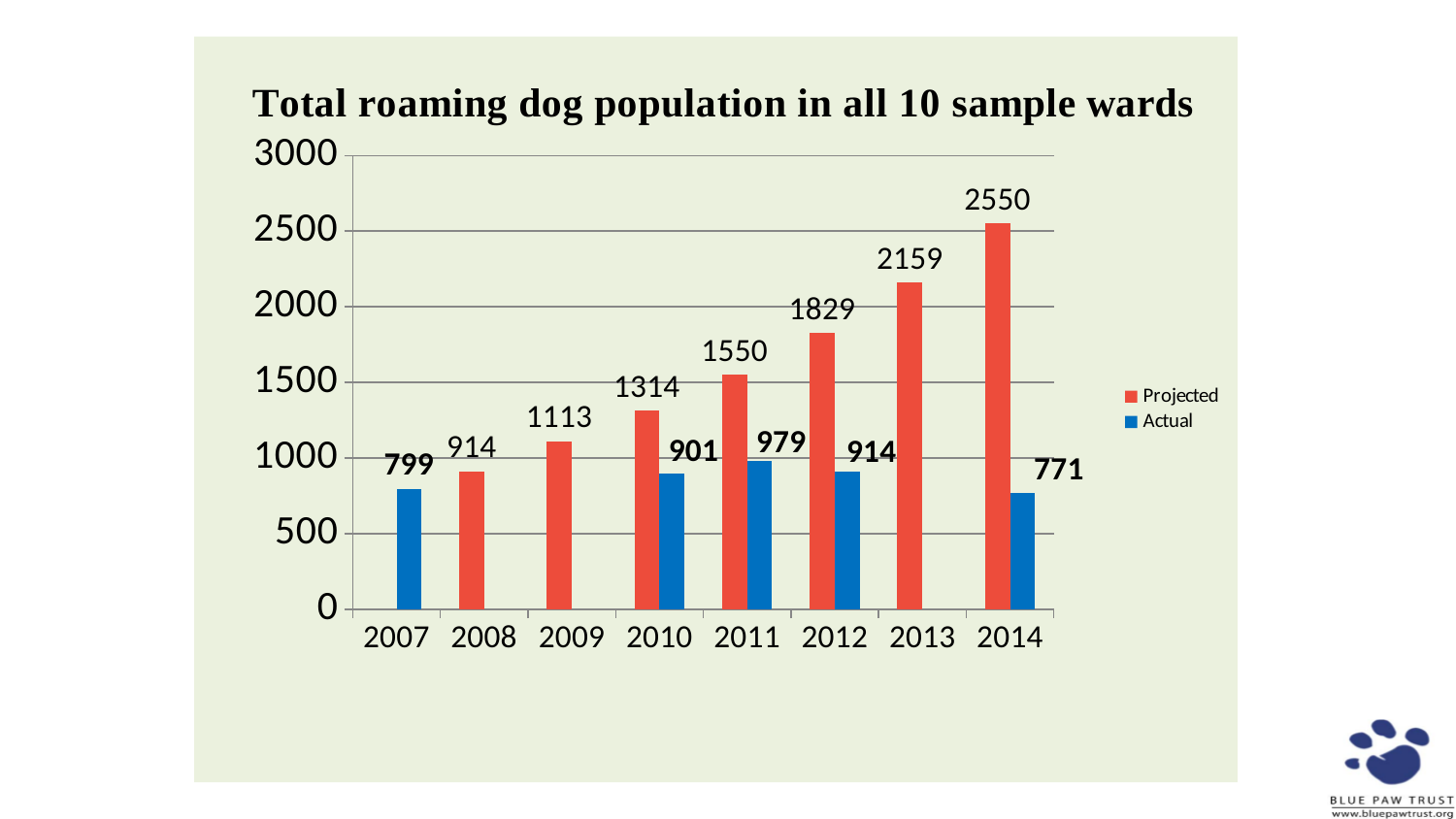
What is the Actual value for 2011? 979 What is the Actual value for 2007? 799 What is the difference between the Projected and Actual values for 2014? 1779 What is the Projected value for 2010? 1314 What kind of chart is shown on the slide? Bar chart Which year has the lowest Actual value? 2014 How many years are shown on the x axis? 8 Which year has the highest Projected value? 2014 What is the Projected value for 2014? 2550 Which is larger for 2012, the Projected value or the Actual value? Projected Do the Projected values rise or fall from 2008 to 2014? Rise How many series does the legend list? 2